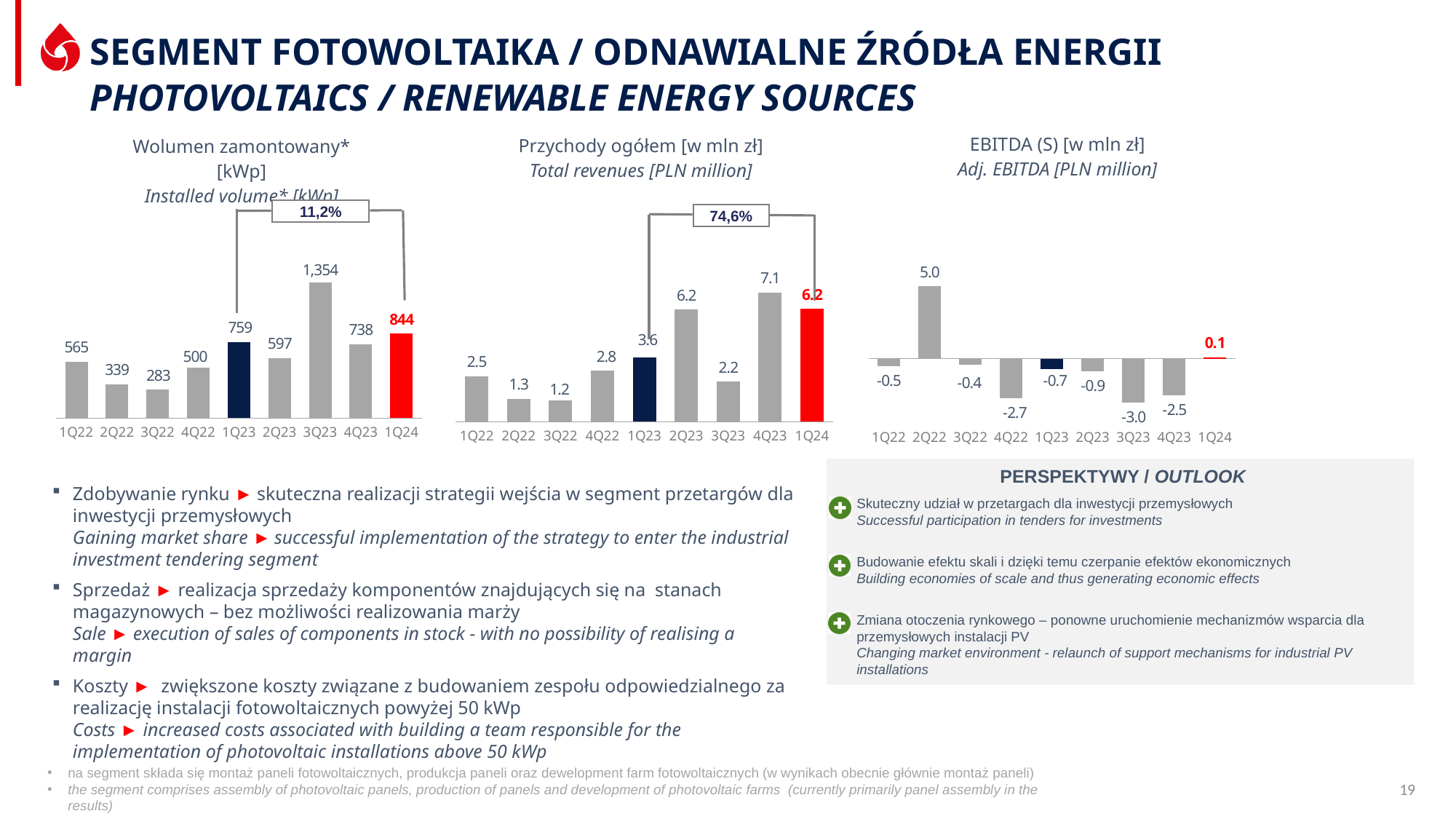
In the Total revenues [PLN million] chart, which quarter has the highest value? 4Q23 In the Installed volume [kWp] chart, what is the value for 3Q23? 1,354 In the Installed volume [kWp] chart, what percentage change is shown in the box above the bars? 11,2% In the Total revenues [PLN million] chart, what is the value for 4Q23? 7.1 In the Adj. EBITDA [PLN million] chart, what is the value for 1Q24? 0.1 What type of chart is used for the Adj. EBITDA [PLN million] chart? Bar chart In the Adj. EBITDA [PLN million] chart, which quarter has the lowest value? 3Q23 In the Total revenues [PLN million] chart, how many quarters are shown? 9 In the Total revenues [PLN million] chart, which is larger, 1Q23 or 3Q23? 1Q23 In the Installed volume [kWp] chart, what is the difference between 1Q24 and 1Q23? 85 In the Installed volume [kWp] chart, which quarter has the lowest value? 3Q22 In the Adj. EBITDA [PLN million] chart, what is the value for 2Q22? 5.0